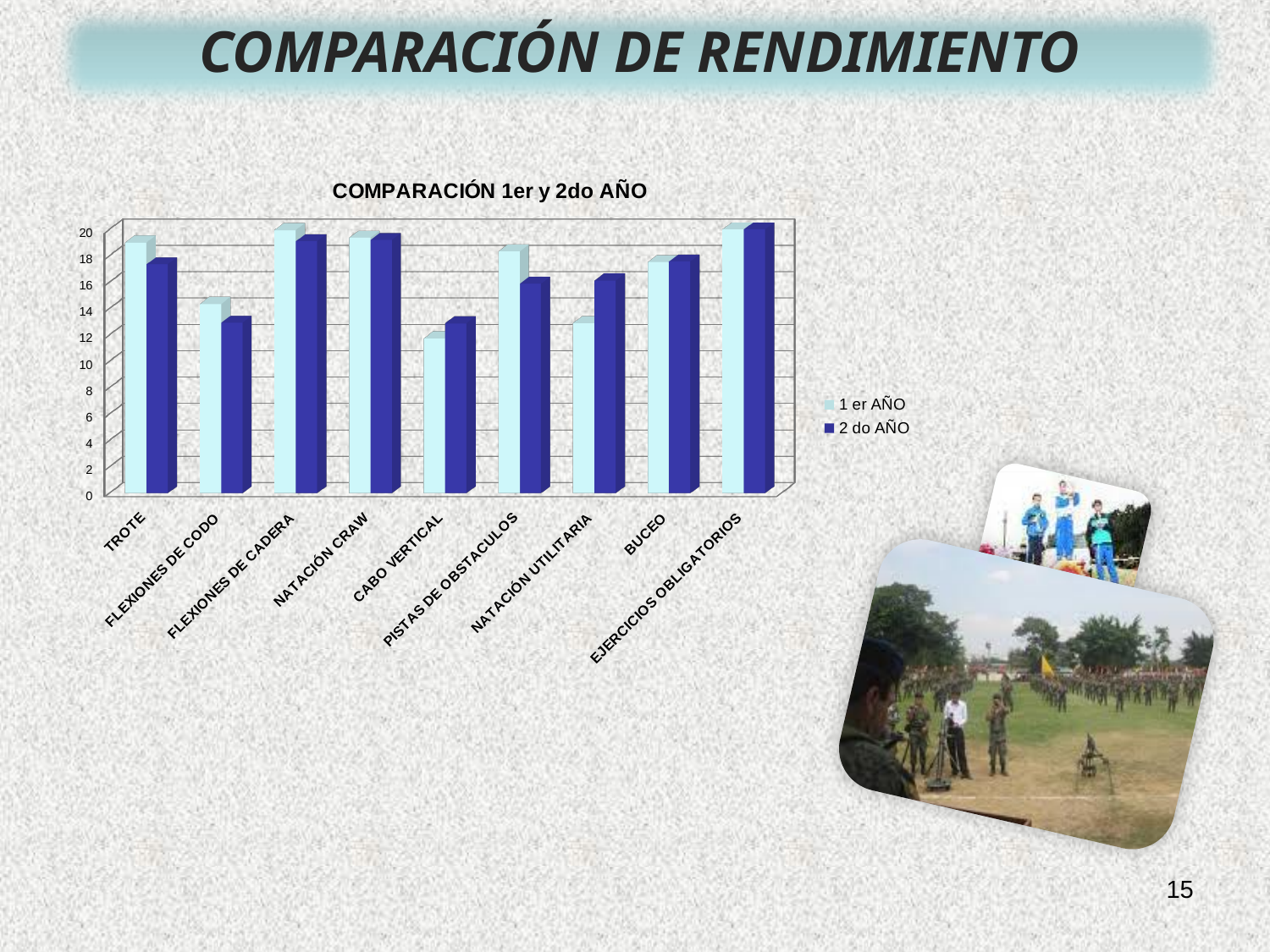
For PISTAS DE OBSTACULOS, which series has the larger value, 1 er AÑO or 2 do AÑO? 1 er AÑO Is the 1 er AÑO value for FLEXIONES DE CADERA greater or less than 18? greater What kind of chart is shown on the slide? Bar chart For TROTE, which series has the larger value, 1 er AÑO or 2 do AÑO? 1 er AÑO What is the title of the chart? COMPARACIÓN 1er y 2do AÑO How many series does the chart legend list? 2 Is the 1 er AÑO value for CABO VERTICAL greater or less than 14? less Is the 1 er AÑO value for TROTE greater or less than 16? greater For NATACIÓN UTILITARIA, which series has the larger value, 1 er AÑO or 2 do AÑO? 2 do AÑO Which series is drawn in dark blue in the chart? 2 do AÑO How many categories are shown on the x axis of the chart? 9